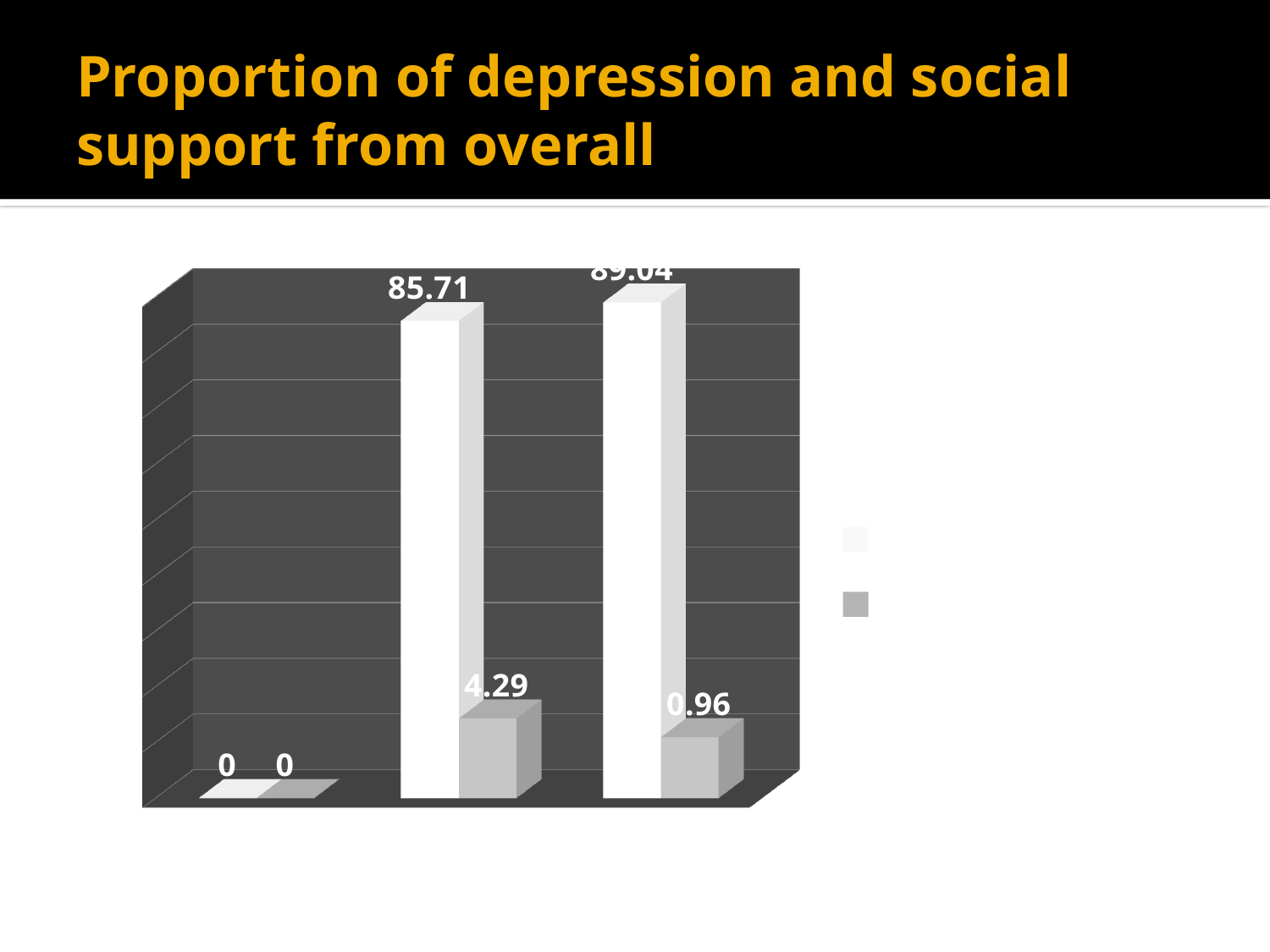
What is the value of the white bar in the middle group? 85.71 How many groups of bars are plotted in the chart? 3 How many series does the chart's legend list? 2 What values are labelled on the two bars in the leftmost group? 0 and 0 What is the title of the slide? Proportion of depression and social support from overall Which group has the highest grey bar? The middle group Which is larger: the grey bar in the middle group or the grey bar in the rightmost group? The grey bar in the middle group What kind of chart is shown on the slide? Bar chart